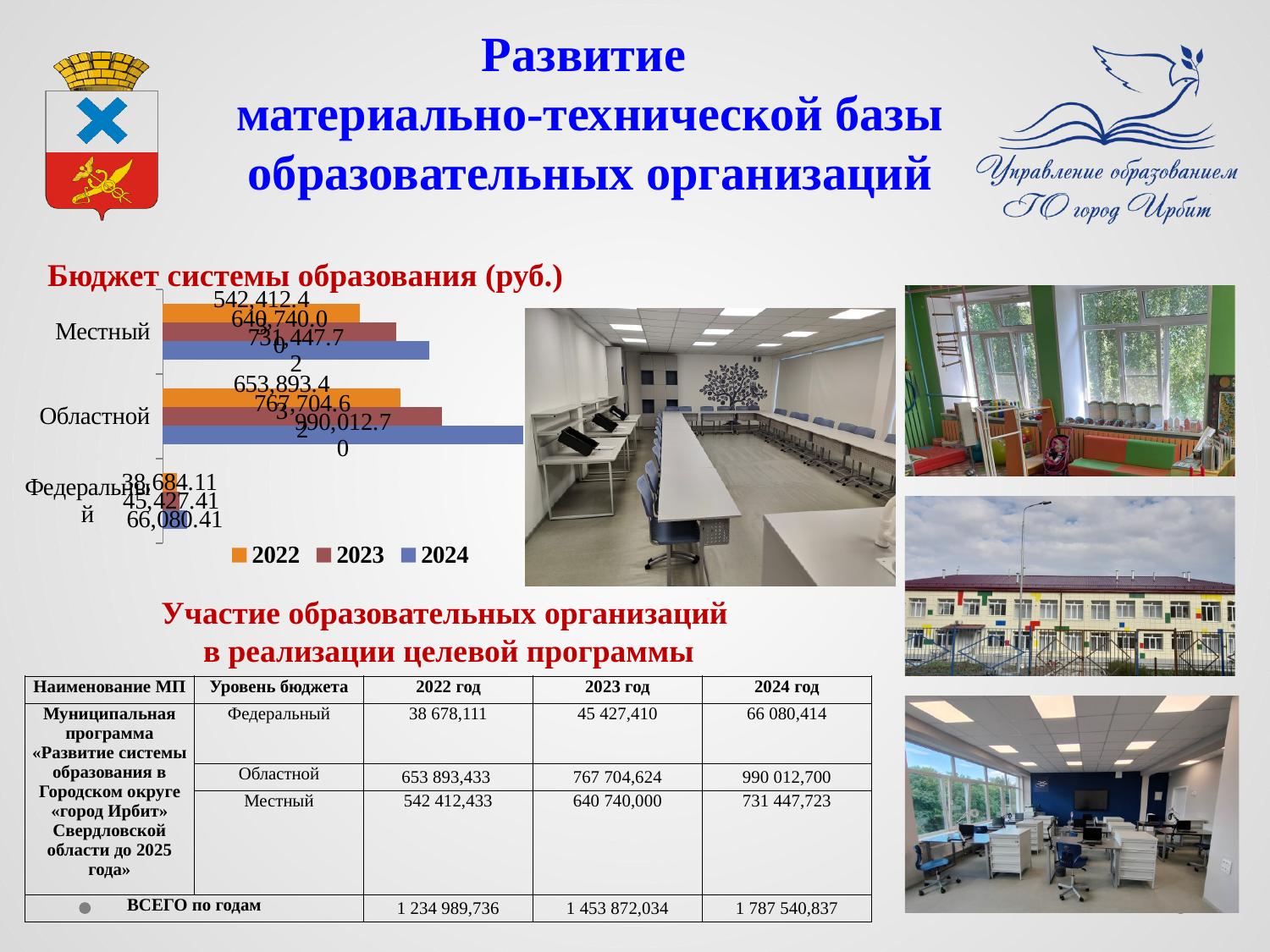
What kind of chart is used to show the education system budget (Бюджет системы образования)? bar chart For the Областной category, do the bars rise or fall from 2022 to 2024? rise Which years are listed in the legend of the budget chart? 2022, 2023, 2024 Which year has the longest bar for the Местный category? 2024 Which budget level has the longest bar for 2024 on the budget chart? Областной On the budget chart, which is larger for 2024: Местный or Областной? Областной Which budget level has the shortest bars on the budget chart? Федеральный How many series does the legend of the budget chart list? 3 What is the title of the chart on the slide? Бюджет системы образования (руб.) For the Местный category, do the bars rise or fall from 2022 to 2024? rise How many budget-level categories are shown on the budget chart? 3 On the budget chart, which is larger for 2022: Федеральный or Местный? Местный